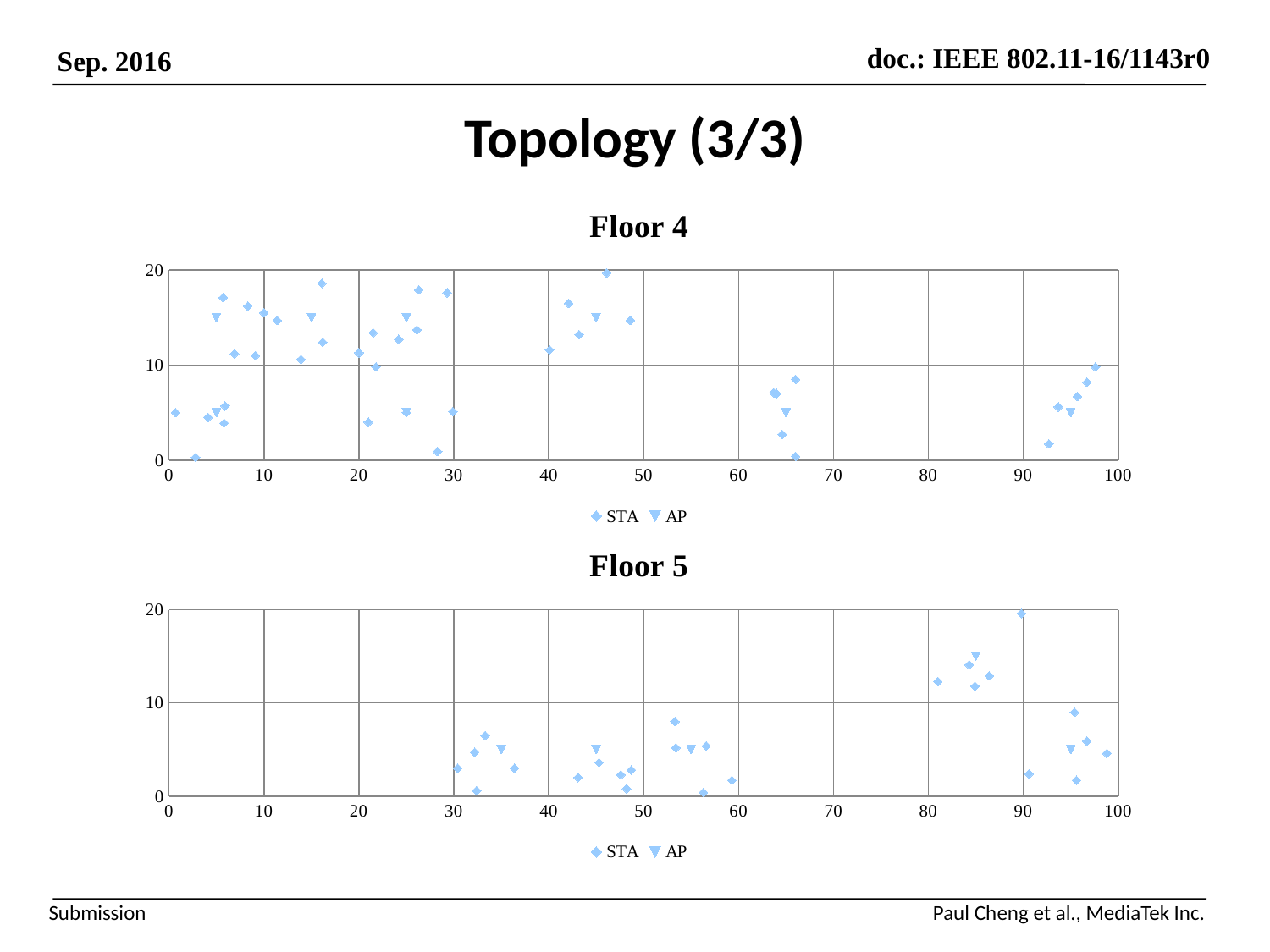
How many series does the legend of the Floor 5 chart list? 2 In the Floor 4 chart, is the highest y value of any point greater or less than 10? greater In the Floor 5 chart, is the smallest x value of any point greater or less than 20? greater In the Floor 5 chart, is the highest y value of any point greater or less than 10? greater What kind of chart is the Floor 5 chart? Scatter chart How many AP markers are plotted in the Floor 4 chart? 8 How many series does the legend of the Floor 4 chart list? 2 How many AP markers are plotted in the Floor 5 chart? 5 What is the title of the top chart on the slide? Floor 4 What kind of chart is the Floor 4 chart? Scatter chart Which chart has more AP markers, Floor 4 or Floor 5? Floor 4 What are the legend entries of the Floor 5 chart? STA, AP